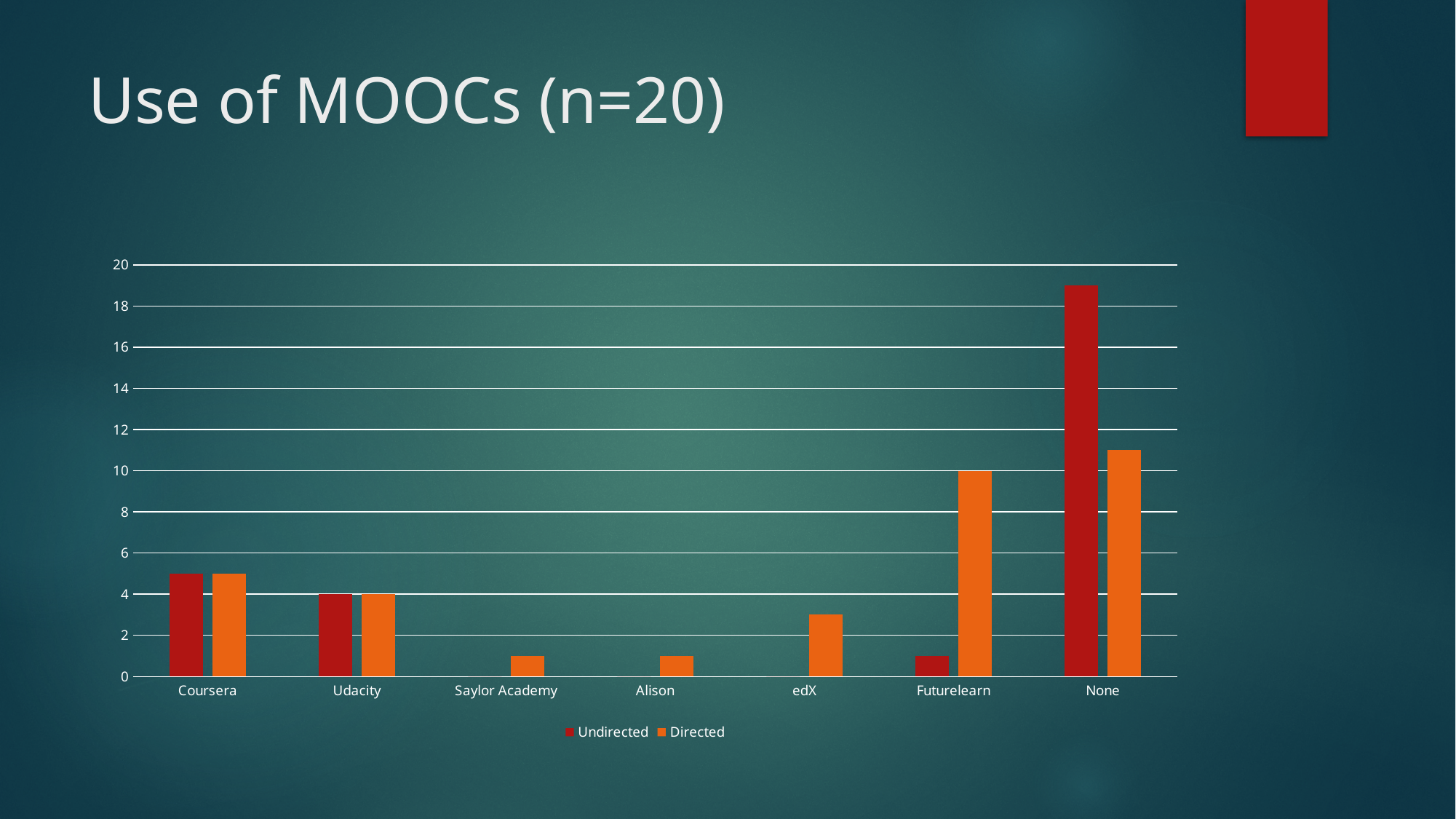
What is the Directed value for Futurelearn? 10 How many categories are shown on the x axis? 7 Is the Directed value for edX greater or less than 4? less Which category has the highest Undirected value? None For Futurelearn, which is larger, the Undirected or the Directed value? Directed Which colour represents the Directed series in the legend? orange How many series does the legend list? 2 What type of chart is shown on the slide? bar chart What is the title of the chart? Use of MOOCs (n=20) What is the Undirected value for Udacity? 4 Is the Undirected value for None greater or less than 18? greater Which category has the highest Directed value? None